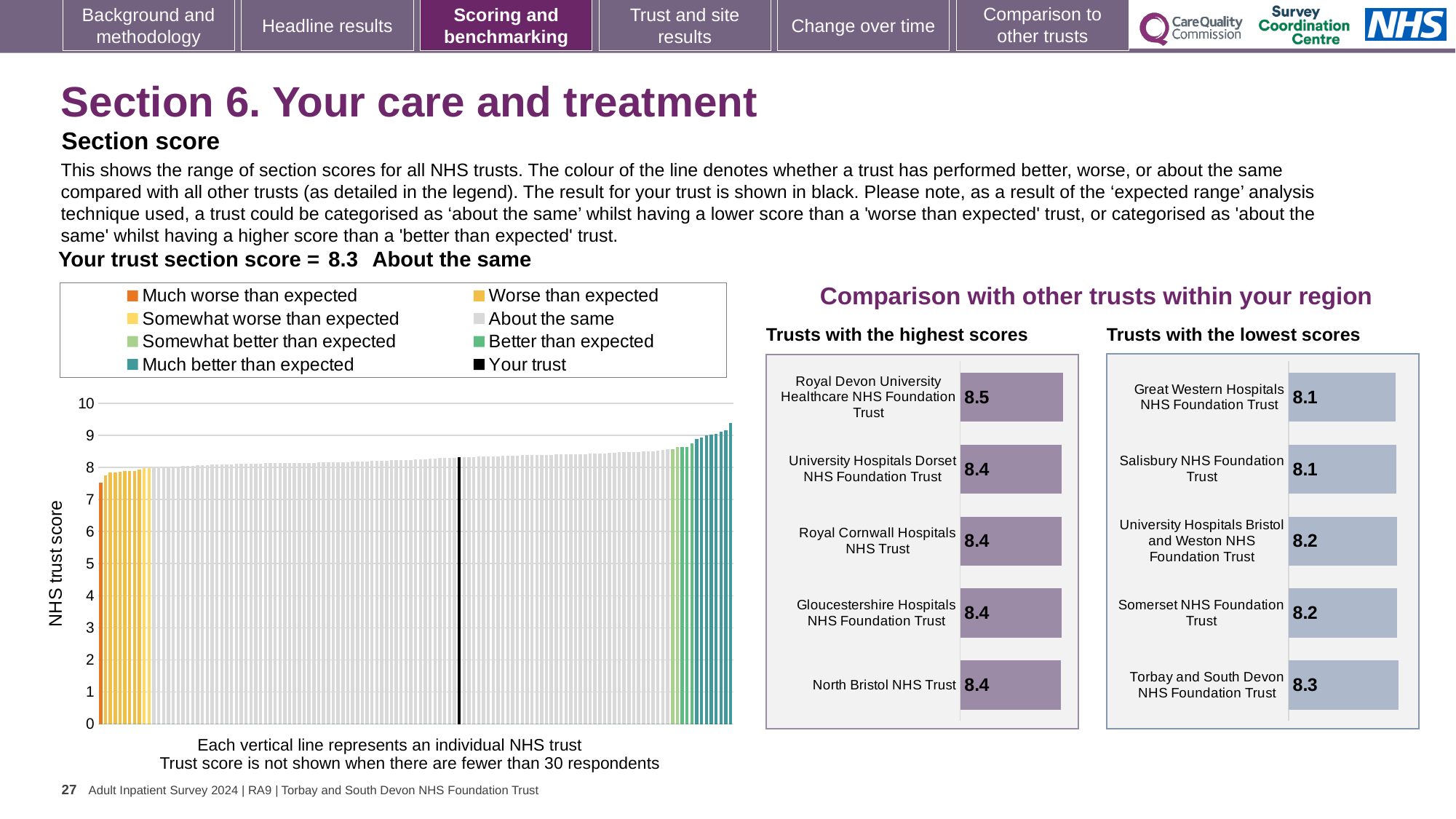
How many entries does the legend of the main 'NHS trust score' chart list? 8 In the main 'NHS trust score' chart, is the value for the black 'Your trust' bar greater or less than 9? less In the 'Trusts with the lowest scores' chart, what is the score for Somerset NHS Foundation Trust? 8.2 In the 'Trusts with the lowest scores' chart, which trust has the highest score? Torbay and South Devon NHS Foundation Trust What kind of chart is the main 'NHS trust score' chart on the left? Bar chart In the 'Trusts with the highest scores' chart, what is the score for Royal Devon University Healthcare NHS Foundation Trust? 8.5 In the 'Trusts with the highest scores' chart, which trust has the highest score? Royal Devon University Healthcare NHS Foundation Trust In the 'Trusts with the lowest scores' chart, which has the larger score: Salisbury NHS Foundation Trust or Torbay and South Devon NHS Foundation Trust? Torbay and South Devon NHS Foundation Trust In the main 'NHS trust score' chart, do the trust scores rise or fall from left to right along the x axis? Rise In the 'Trusts with the lowest scores' chart, what is the difference between the scores of Torbay and South Devon NHS Foundation Trust and Great Western Hospitals NHS Foundation Trust? 0.2 In the 'Trusts with the highest scores' chart, what is the difference between the scores of Royal Devon University Healthcare NHS Foundation Trust and North Bristol NHS Trust? 0.1 How many trusts are listed in the 'Trusts with the highest scores' chart? 5